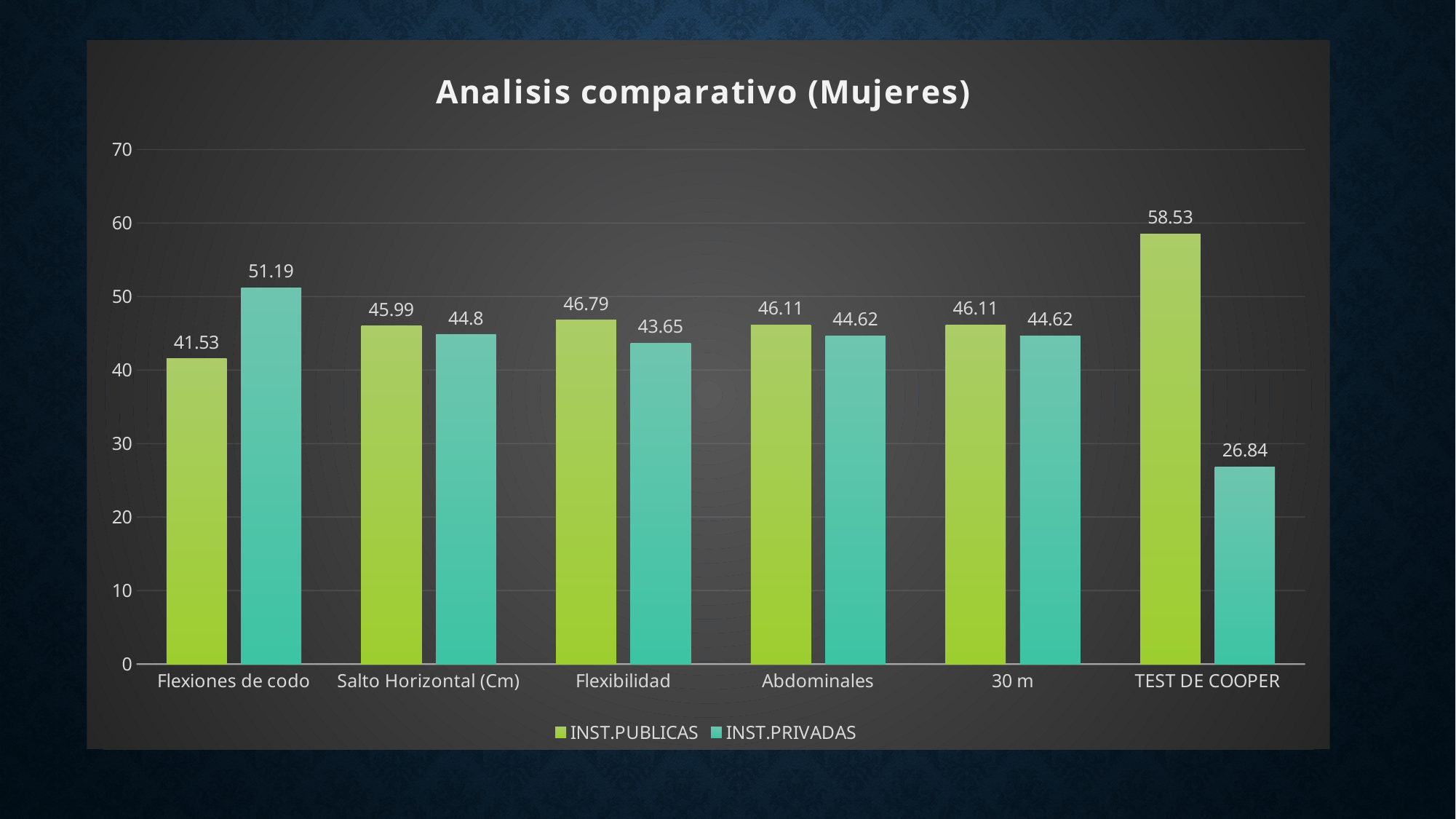
What kind of chart is shown on the slide? bar chart What is the title of the chart? Analisis comparativo (Mujeres) For Flexiones de codo, which series has the larger value, INST.PUBLICAS or INST.PRIVADAS? INST.PRIVADAS What is the difference between the INST.PUBLICAS and INST.PRIVADAS values for TEST DE COOPER? 31.69 Which category has the highest INST.PUBLICAS value? TEST DE COOPER How many categories are shown on the x axis? 6 What is the INST.PUBLICAS value for Flexiones de codo? 41.53 What is the INST.PRIVADAS value for TEST DE COOPER? 26.84 What is the INST.PRIVADAS value for Flexibilidad? 43.65 Is the INST.PRIVADAS value for Flexiones de codo greater or less than 50? greater How many series does the legend list? 2 Which category has the lowest INST.PRIVADAS value? TEST DE COOPER